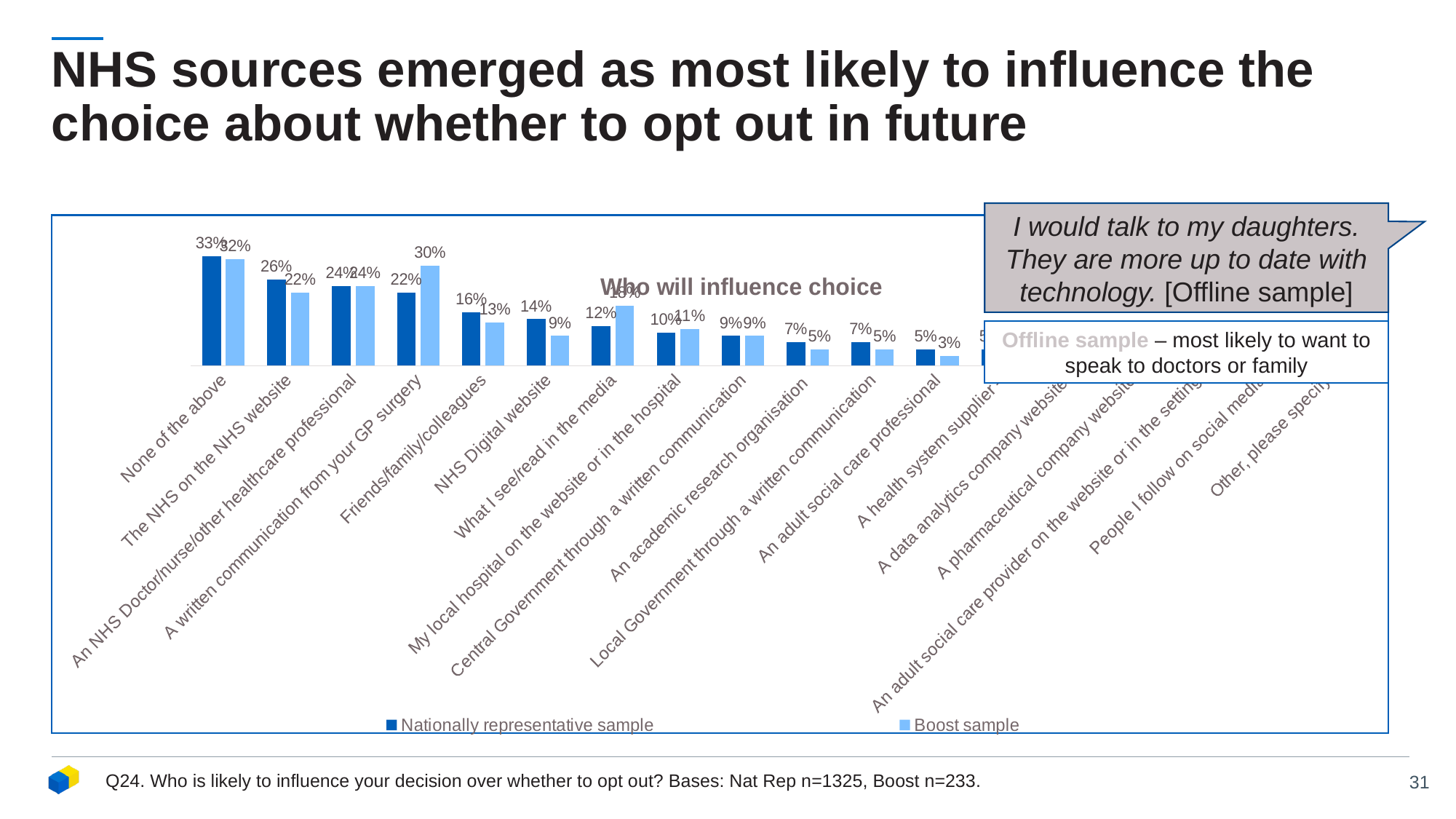
What is the Nationally representative sample value for 'The NHS on the NHS website'? 26% What is the title of the chart? Who will influence choice What is the Boost sample value for 'Central Government through a written communication'? 9% What is the Boost sample value for 'Friends/family/colleagues'? 13% What is the Nationally representative sample value for 'None of the above'? 33% What is the Boost sample value for 'A written communication from your GP surgery'? 30% Which category has the highest Nationally representative sample value? None of the above For 'NHS Digital website', how many percentage points higher is the Nationally representative sample than the Boost sample? 5 percentage points How many series does the legend list? 2 For 'A written communication from your GP surgery', which series has the larger value? Boost sample For 'The NHS on the NHS website', what is the difference between the Nationally representative sample and the Boost sample? 4 percentage points What kind of chart is shown on the slide? Bar chart